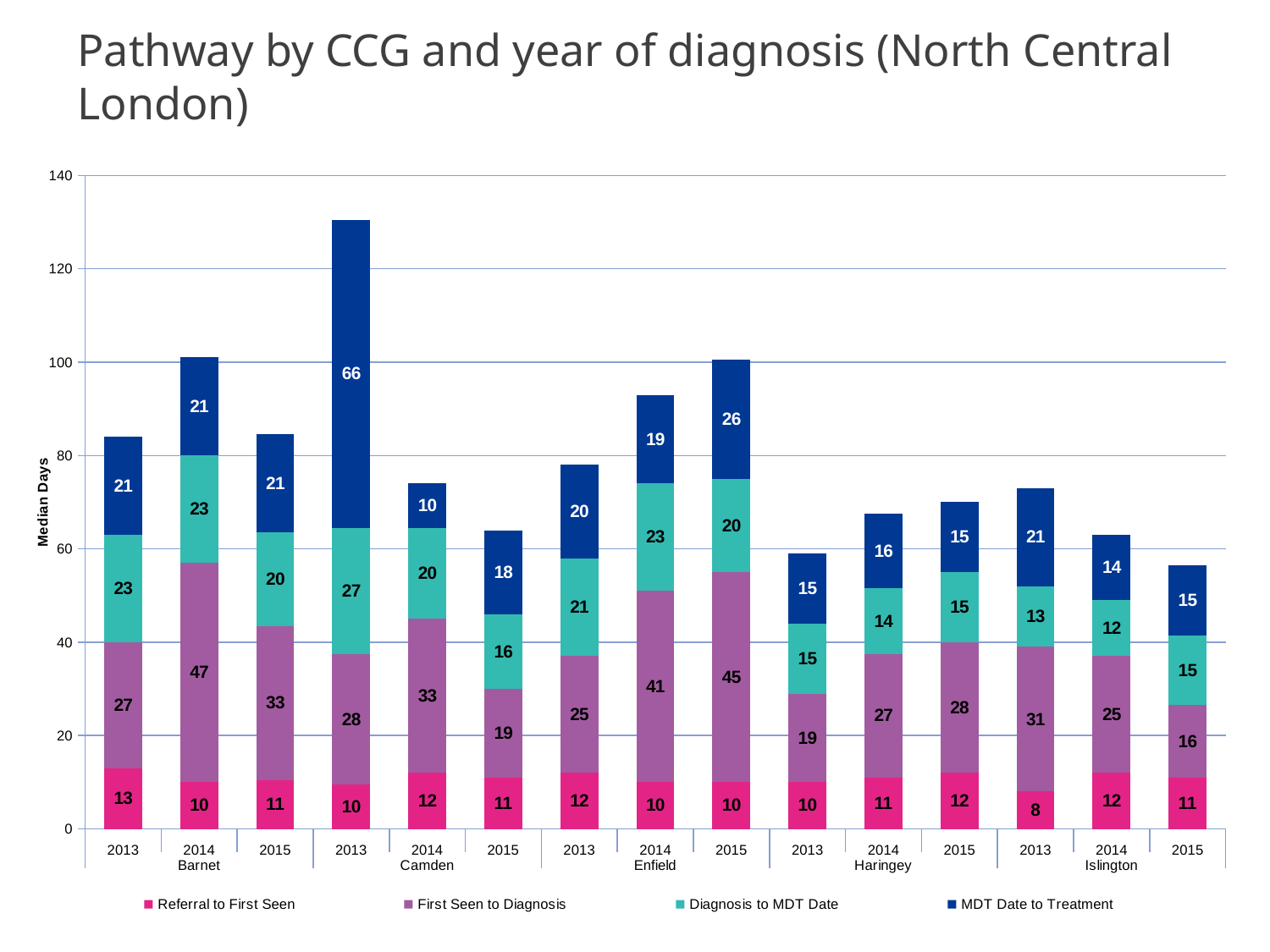
What is the value of Diagnosis to MDT Date for Enfield in 2014? 23 What is the value of MDT Date to Treatment for Camden in 2013? 66 What is the difference between the First Seen to Diagnosis values for Enfield in 2015 and Enfield in 2013? 20 Which CCG and year has the lowest Referral to First Seen value? Islington 2013 What is the value of First Seen to Diagnosis for Barnet in 2014? 47 What type of chart is shown on the slide? Stacked bar chart Is the total stacked bar for Camden 2013 greater or less than 120? greater Which is larger: the MDT Date to Treatment value for Barnet 2014 or for Camden 2014? Barnet 2014 How many series does the legend list? 4 What is the total of the stacked bar for Haringey 2013? 59 How many stacked bars are shown in the chart? 15 Which CCG and year has the highest MDT Date to Treatment value? Camden 2013